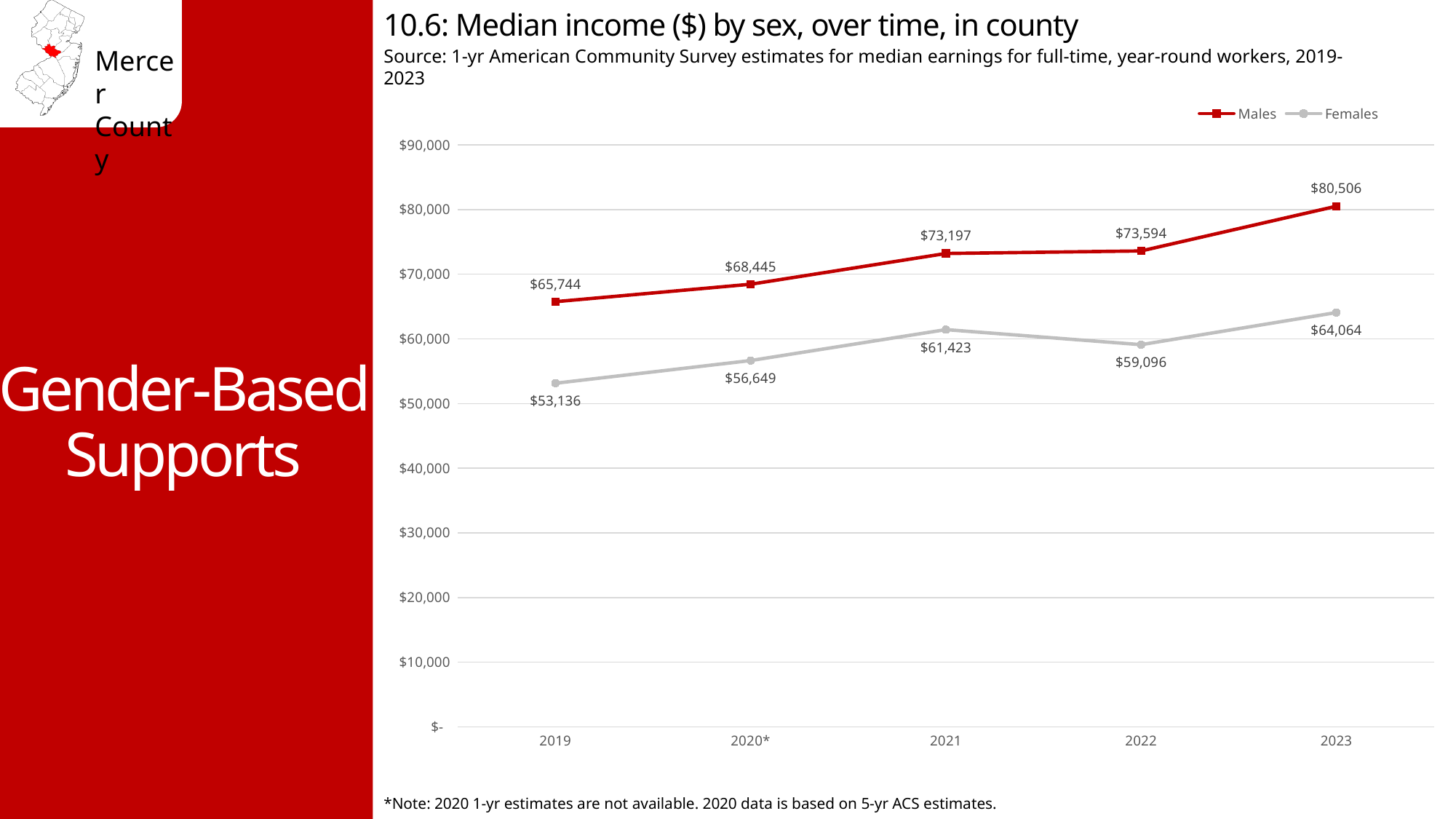
What was the median income for females in 2022? $59,096 What is the difference between male median income in 2021 and 2019? $7,453 Which is larger: female median income in 2021 or in 2022? 2021 How many years are shown on the x axis? 5 Is the male median income in 2020* greater or less than $70,000? less In which year was the median income for females lowest? 2019 In which year was the median income for males highest? 2023 What was the median income for females in 2019? $53,136 What is the difference between male and female median income in 2023? $16,442 What kind of chart is shown on the slide? line chart What was the median income for males in 2023? $80,506 How many series does the legend list? 2